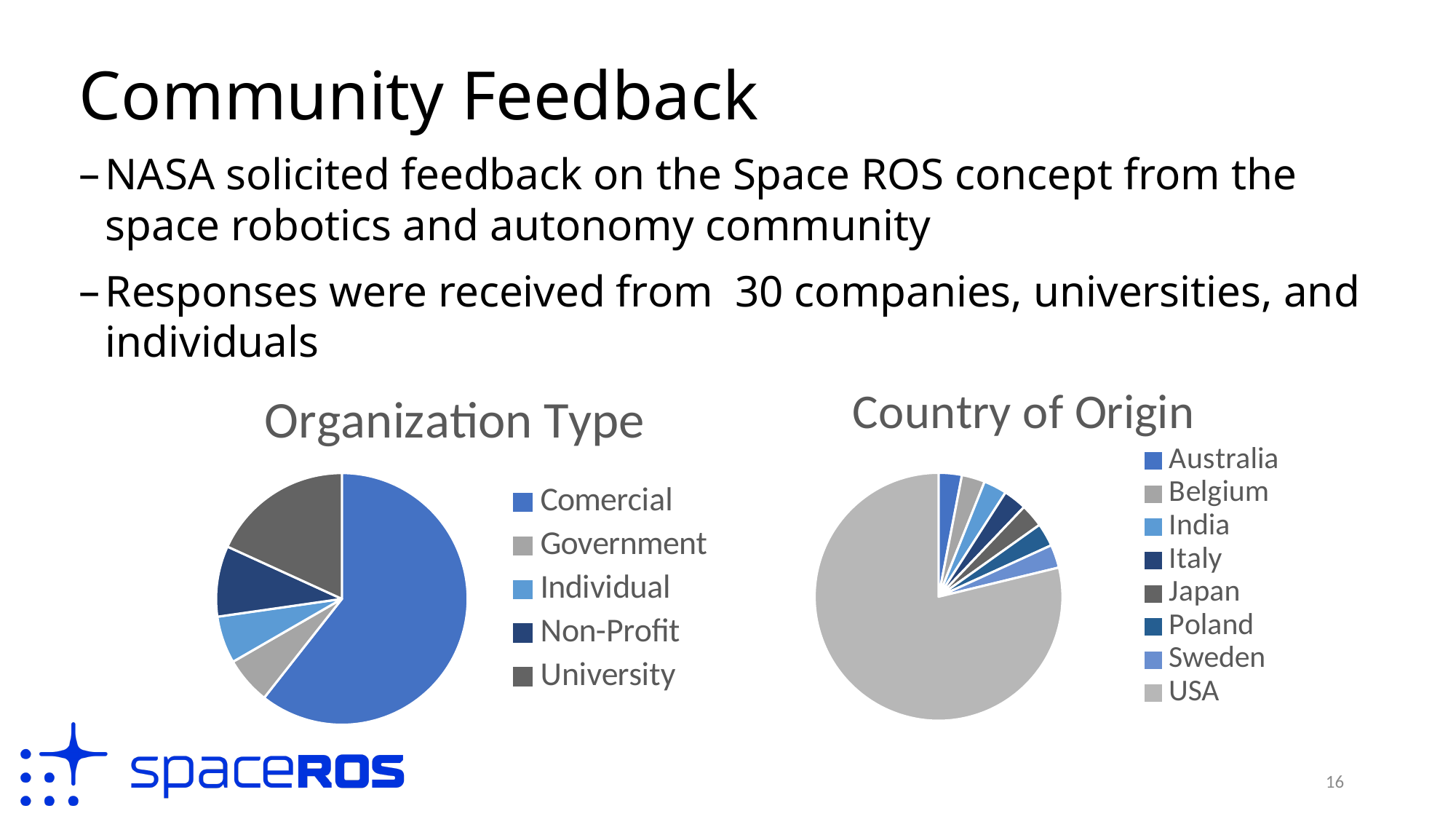
In the Organization Type chart, which category is shown in the darkest grey colour? University How many categories does the Organization Type chart show? 5 What kind of chart is the Country of Origin chart? pie chart What is the title of the pie chart on the right of the slide? Country of Origin In the Organization Type chart, which is larger, the Non-Profit slice or the Individual slice? Non-Profit In the Country of Origin chart, which country has the largest slice? USA What kind of chart is the Organization Type chart? pie chart In the Organization Type chart, which is larger, the Comercial slice or the University slice? Comercial In the Organization Type chart, which is larger, the University slice or the Non-Profit slice? University In the Organization Type chart, which organization type has the largest slice? Comercial How many countries does the Country of Origin chart show? 8